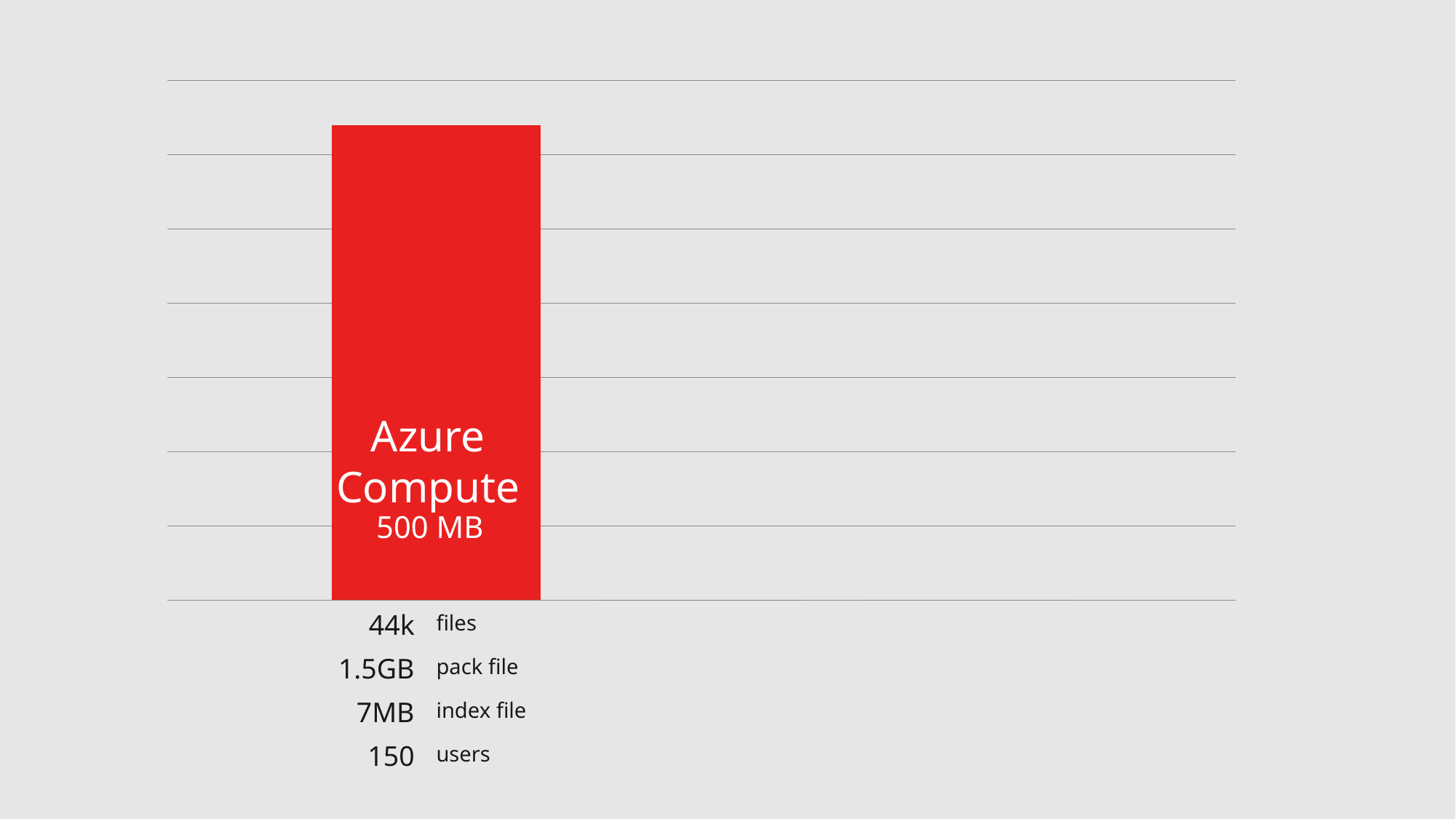
What kind of chart is shown on the slide? bar chart How many bars are plotted on the chart? 1 According to the text beneath the Azure Compute bar, how many files are there? 44k What colour is the Azure Compute bar? red What value is printed on the Azure Compute bar? 500 MB What is the label of the only bar on the chart? Azure Compute